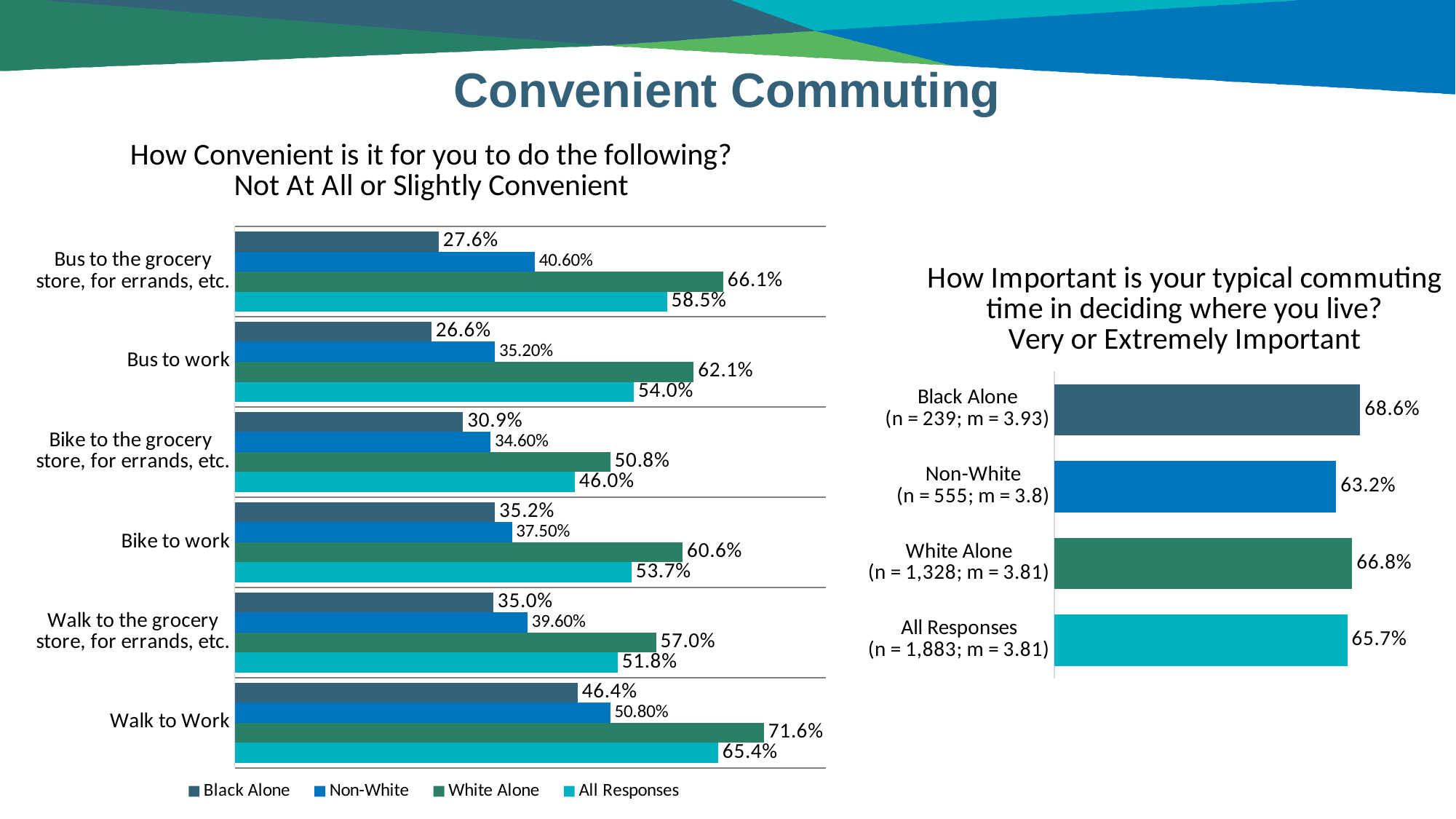
In the right chart (How Important is your typical commuting time in deciding where you live?), what is the value for Non-White? 63.2% In the left chart (How Convenient is it for you to do the following?), what is the White Alone value for Walk to Work? 71.6% In the left chart (How Convenient is it for you to do the following?), how many series does the legend list? 4 In the left chart (How Convenient is it for you to do the following?), what is the difference between the White Alone and Black Alone values for Bus to the grocery store, for errands, etc.? 38.5% What kind of chart is the right chart (How Important is your typical commuting time in deciding where you live?)? Bar chart In the left chart (How Convenient is it for you to do the following?), which category has the lowest White Alone value? Bike to the grocery store, for errands, etc. In the right chart (How Important is your typical commuting time in deciding where you live?), which group has the highest value? Black Alone In the left chart (How Convenient is it for you to do the following?), how many categories are shown? 6 In the left chart (How Convenient is it for you to do the following?), what is the Non-White value for Bus to work? 35.20% In the left chart (How Convenient is it for you to do the following?), what is the All Responses value for Bike to the grocery store, for errands, etc.? 46.0% In the left chart (How Convenient is it for you to do the following?), which category has the highest Black Alone value? Walk to Work In the right chart (How Important is your typical commuting time in deciding where you live?), what is the difference between the White Alone and All Responses values? 1.1%